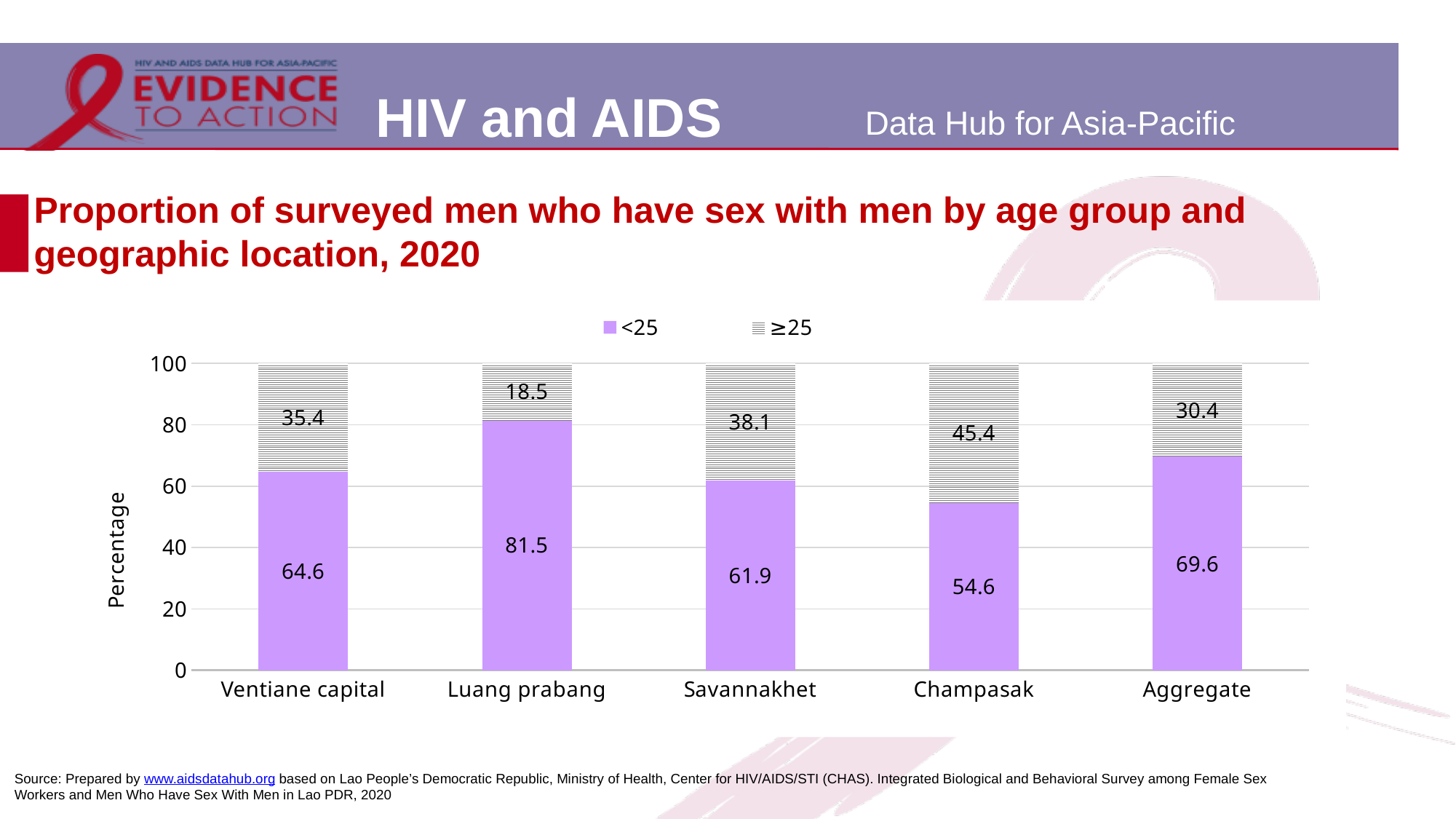
What is the total of the stacked bar for Ventiane capital? 100 What is the value for the <25 age group in Luang prabang? 81.5 How many series does the legend list? 2 What is the difference between the <25 values for Ventiane capital and Savannakhet? 2.7 What is the label of the y axis? Percentage Which location has the lowest value for the ≥25 age group? Luang prabang Which location has the highest value for the <25 age group? Luang prabang What is the value for the ≥25 age group in Champasak? 45.4 What kind of chart is shown on the slide? Stacked bar chart How many geographic locations are shown on the x axis? 5 What is the value for the <25 age group in the Aggregate bar? 69.6 Which is larger: the <25 value for Champasak or the <25 value for Savannakhet? Savannakhet